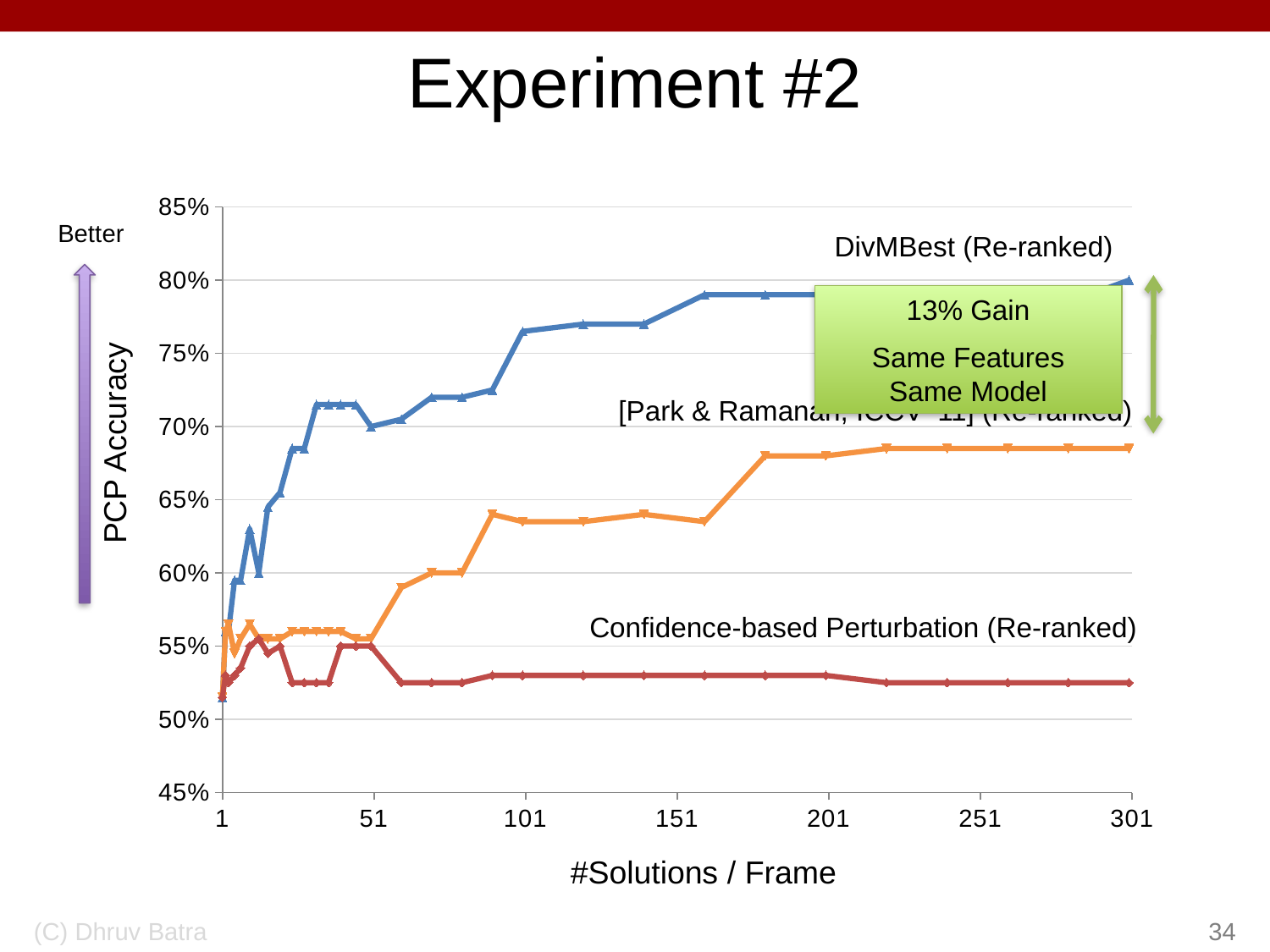
How many series are plotted on the chart? 3 What kind of chart is shown on the slide? line chart Is the PCP Accuracy of [Park & Ramanan, ICCV '11] (Re-ranked) at 301 solutions per frame greater or less than 70%? less Which series has the highest PCP Accuracy at 301 solutions per frame? DivMBest (Re-ranked) At 151 solutions per frame, which series has higher PCP Accuracy: DivMBest (Re-ranked) or [Park & Ramanan, ICCV '11] (Re-ranked)? DivMBest (Re-ranked) Is the PCP Accuracy of DivMBest (Re-ranked) at 101 solutions per frame greater or less than 75%? greater Is the PCP Accuracy of Confidence-based Perturbation (Re-ranked) at 301 solutions per frame greater or less than 55%? less What is the title of the slide containing the chart? Experiment #2 What is the label of the y axis? PCP Accuracy Which series has the lowest PCP Accuracy at 301 solutions per frame? Confidence-based Perturbation (Re-ranked) Does the PCP Accuracy of DivMBest (Re-ranked) generally rise or fall as the number of solutions per frame increases? rise